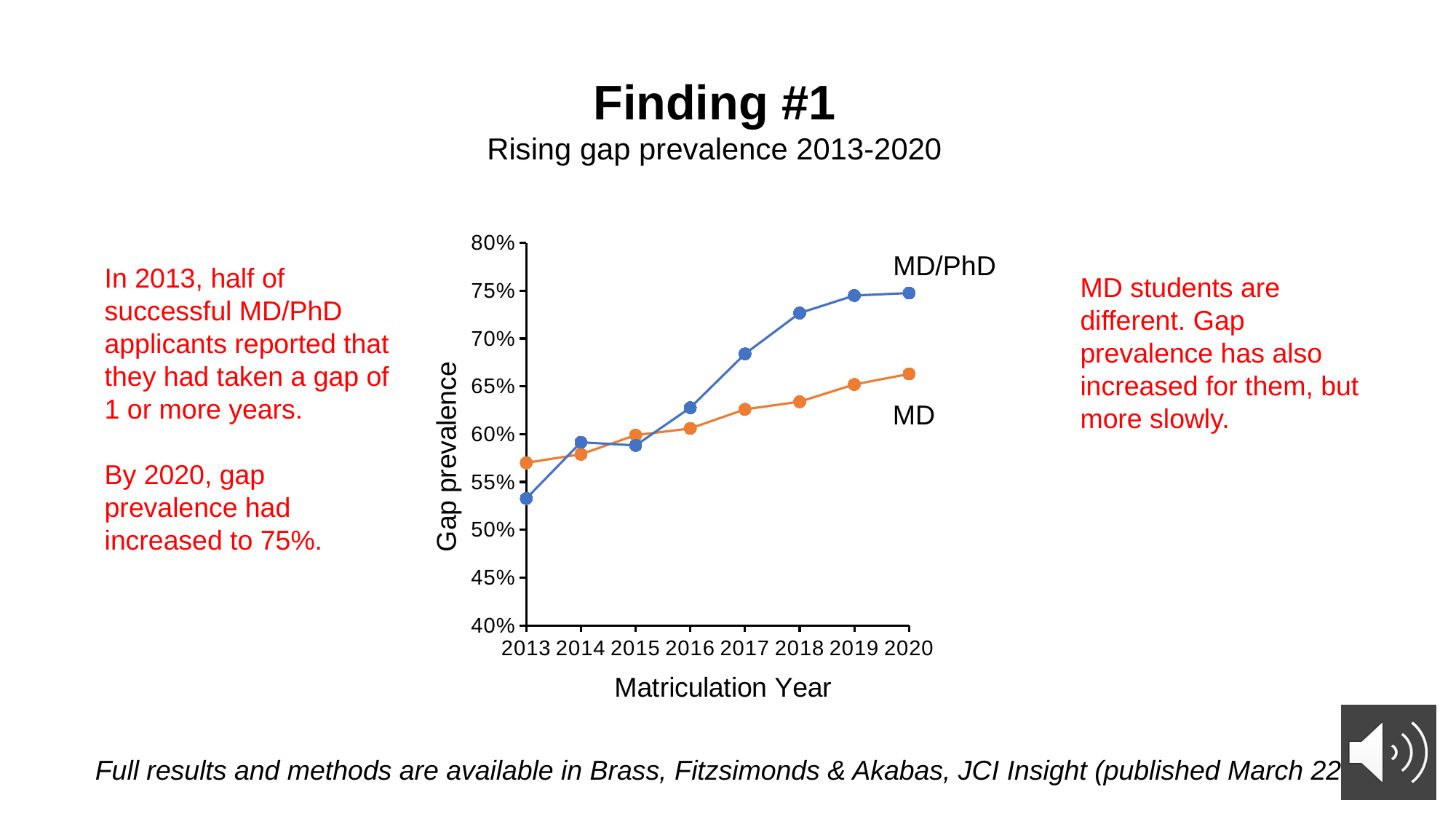
Is the MD gap prevalence for 2020 greater or less than 65%? greater In 2020, which series has the higher gap prevalence, MD/PhD or MD? MD/PhD How many series are plotted on the chart? 2 Does the MD gap prevalence generally rise or fall from 2013 to 2020? rise Is the MD/PhD gap prevalence for 2017 greater or less than 70%? less Which matriculation year has the lowest gap prevalence for the MD/PhD series? 2013 In 2013, which series has the higher gap prevalence, MD/PhD or MD? MD How many matriculation years are plotted along the x axis? 8 Does the MD/PhD gap prevalence generally rise or fall from 2013 to 2020? rise Is the MD/PhD gap prevalence for 2018 greater or less than 70%? greater What kind of chart is shown on the slide? line chart